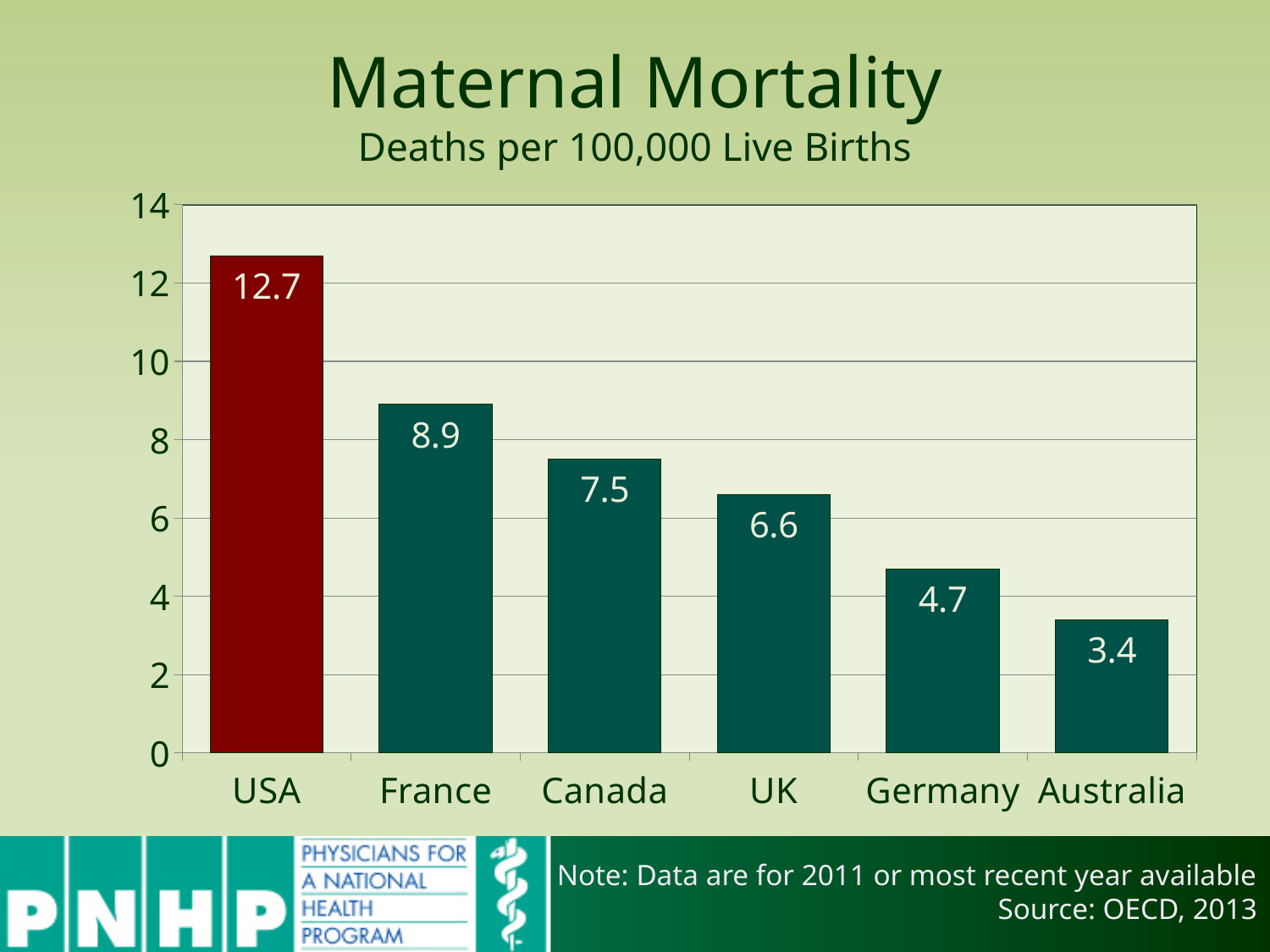
Is the value for France greater or less than 10? less Which bar is coloured differently (dark red) from the others? USA What is the maternal mortality value for the UK? 6.6 What is the maternal mortality value for the USA? 12.7 Which country has the highest maternal mortality rate? USA Which has a higher maternal mortality rate, Canada or the UK? Canada What kind of chart is shown on the slide? bar chart What is the maternal mortality value for Germany? 4.7 How many countries are shown in the chart? 6 What is the difference between the maternal mortality values for Canada and Australia? 4.1 What is the difference between the maternal mortality values for the USA and France? 3.8 Which country has the lowest maternal mortality rate? Australia